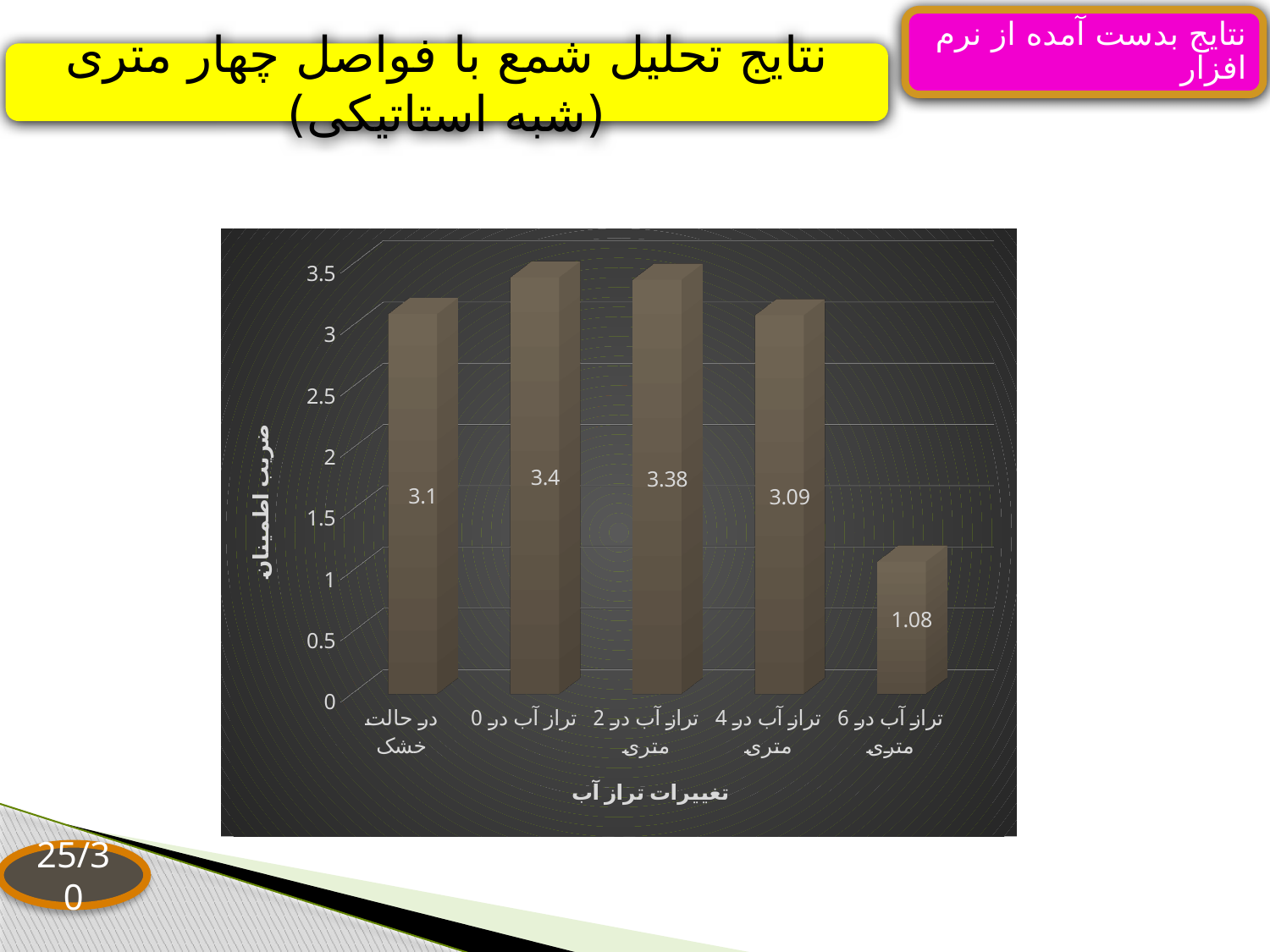
Which category has the lowest safety factor? تراز آب در 6 متری What is the difference between the values for water level at 4 m and water level at 6 m? 2.01 Which is larger, the value for the dry state or the value for water level at 4 m? the dry state (3.1) What is the value shown for water level at 2 m (تراز آب در 2 متری)? 3.38 Which category has the highest safety factor? تراز آب در 0 What is the value shown for water level at 6 m (تراز آب در 6 متری)? 1.08 How many categories are shown on the x axis? 5 What is the label of the x axis of the chart? تغییرات تراز آب What kind of chart is shown on the slide? bar chart What is the safety factor (ضریب اطمینان) value for the dry state (در حالت خشک)? 3.1 What is the value shown for water level at 0 (تراز آب در 0)? 3.4 Is the value for water level at 6 m greater or less than 1.5? less